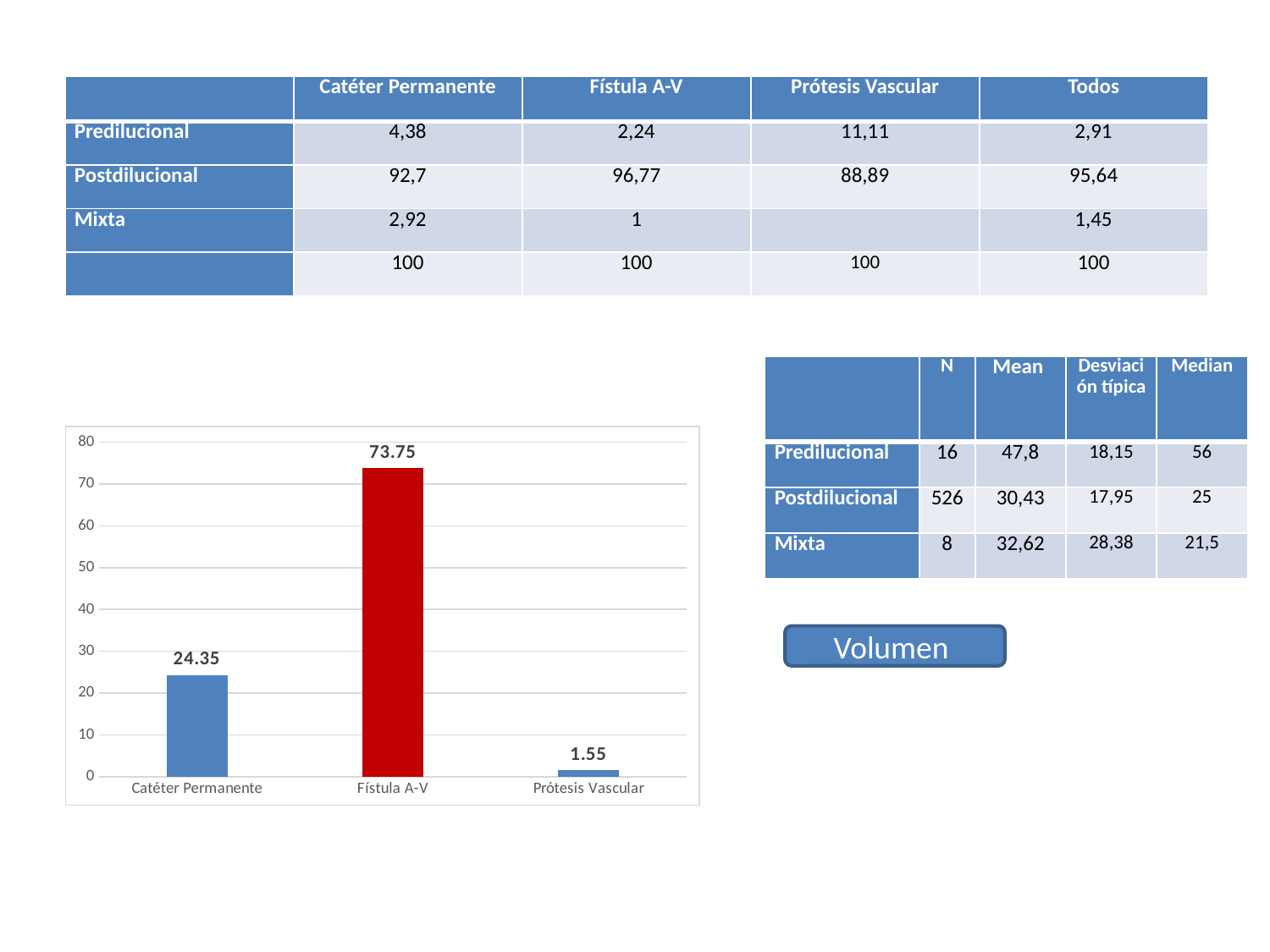
Which category has the lowest value in the bar chart? Prótesis Vascular Is the value for Fístula A-V in the bar chart greater or less than 70? greater How many categories are shown in the bar chart? 3 Which is larger in the bar chart, the value for Catéter Permanente or the value for Prótesis Vascular? Catéter Permanente What is the value for Fístula A-V in the bar chart? 73.75 What is the value for Prótesis Vascular in the bar chart? 1.55 What colour is the bar for Fístula A-V in the bar chart? red What is the difference between the values for Catéter Permanente and Prótesis Vascular in the bar chart? 22.8 What kind of chart is shown on the slide? bar chart What is the difference between the values for Fístula A-V and Catéter Permanente in the bar chart? 49.4 What is the value for Catéter Permanente in the bar chart? 24.35 Which category has the highest value in the bar chart? Fístula A-V